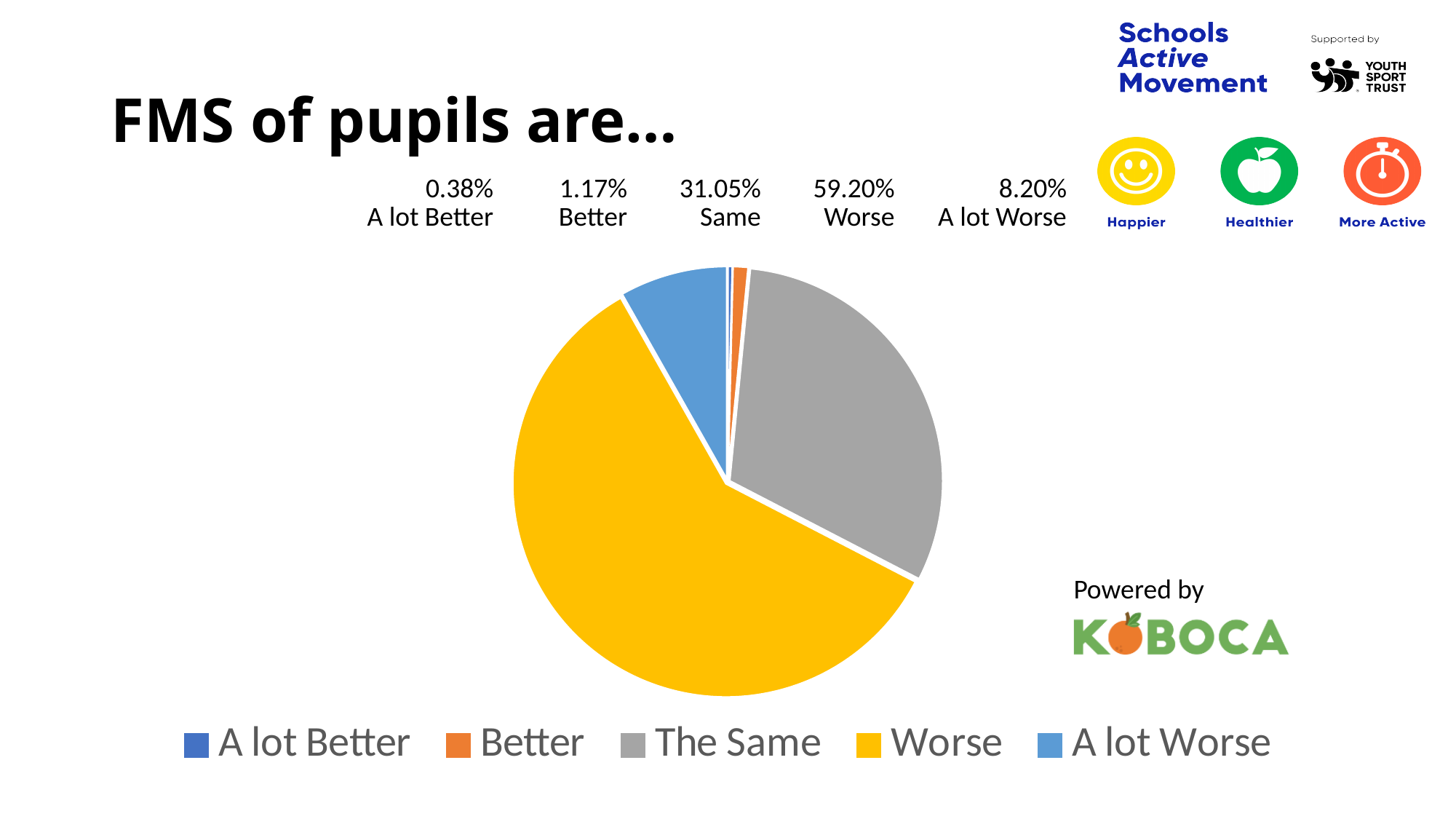
What percentage of pupils' FMS are 'Better'? 1.17% What kind of chart is shown on the slide? pie chart Which category has the largest share of the pie? Worse Which category has the smallest share of the pie? A lot Better Which is larger, the share for 'The Same' or the share for 'A lot Worse'? The Same How many categories does the legend list? 5 What percentage of pupils' FMS are 'A lot Better'? 0.38% What is the difference in percentage points between 'Worse' and 'The Same'? 28.15 What percentage of pupils' FMS are 'The Same'? 31.05% What colour is the 'Worse' slice of the pie? yellow What percentage of pupils' FMS are 'Worse'? 59.20% What percentage of pupils' FMS are 'A lot Worse'? 8.20%